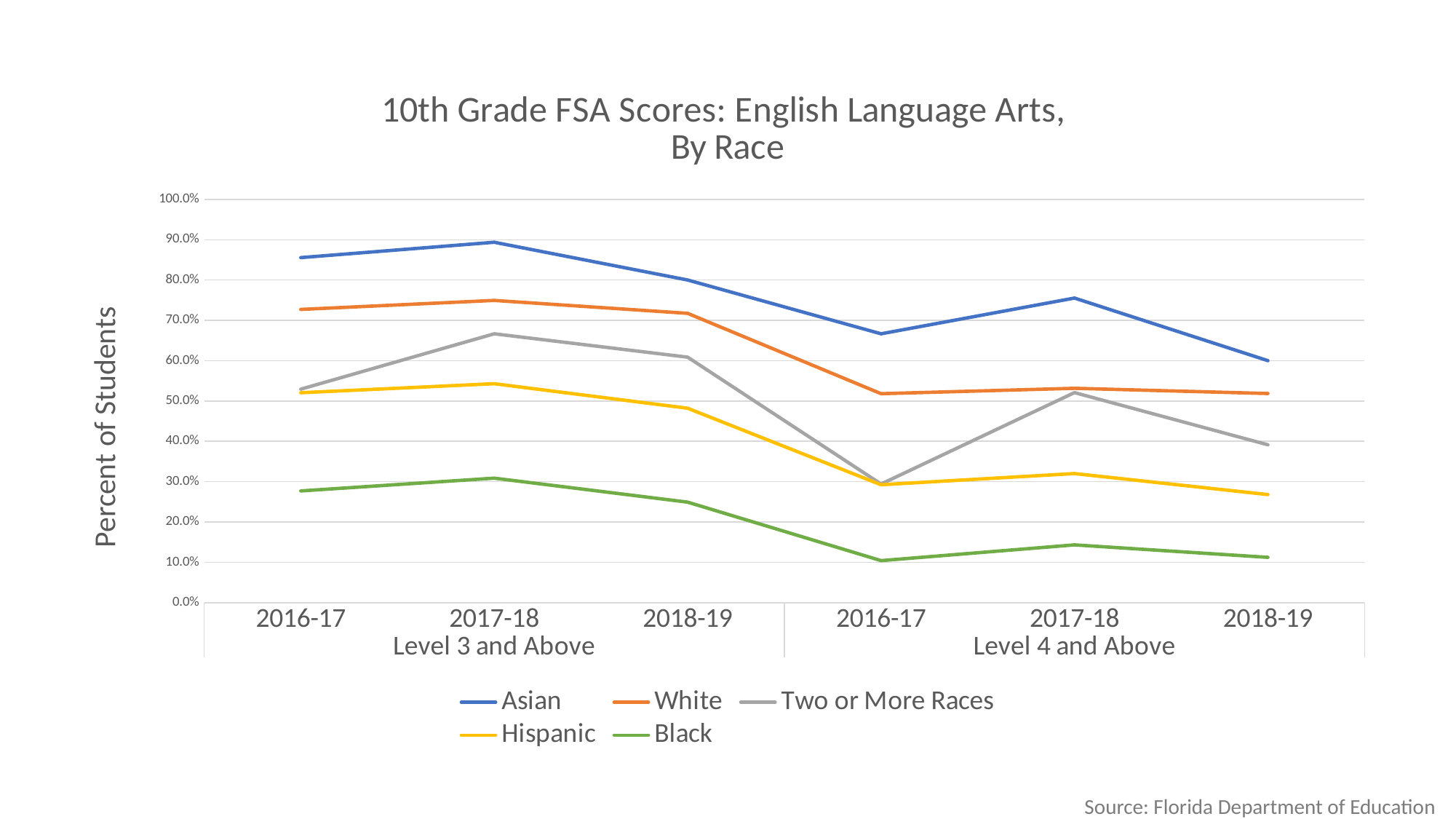
What kind of chart is shown on the slide? line chart What is the label on the vertical axis? Percent of Students How many data points does each line have along the x axis? 6 Is the Black value for 2016-17 under Level 4 and Above greater or less than 20.0%? less Is the Two or More Races value for 2017-18 under Level 3 and Above greater or less than 60.0%? greater Which group has the lowest value for 2016-17 under Level 4 and Above? Black What source is cited for the chart data? Florida Department of Education How many series does the legend list? 5 For 2018-19 under Level 4 and Above, which is larger: the White value or the Two or More Races value? White Does the Asian line rise or fall from 2017-18 to 2018-19 under Level 3 and Above? fall Which group has the highest value for 2017-18 under Level 3 and Above? Asian Is the Asian value for 2017-18 under Level 3 and Above greater or less than 80.0%? greater